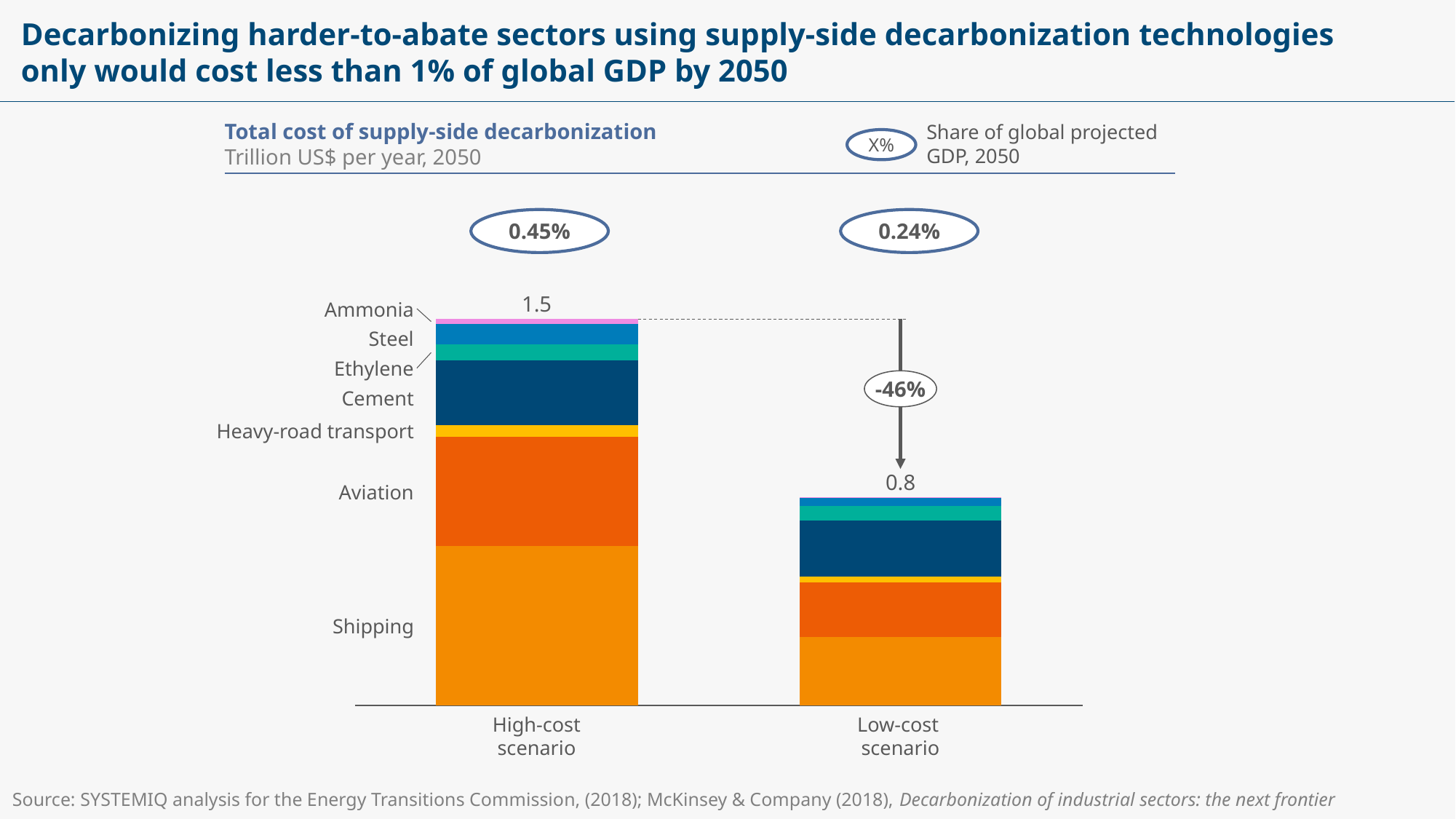
What type of chart is shown on the slide? Stacked bar chart What is the total cost of supply-side decarbonization in the High-cost scenario? 1.5 How many sectors are stacked in each bar? 7 How many scenarios (bars) are shown in the chart? 2 Which sector forms the largest segment of the High-cost scenario bar? Shipping What share of global projected GDP in 2050 does the Low-cost scenario represent? 0.24% Which scenario has the higher total cost? High-cost scenario What is the total cost of supply-side decarbonization in the Low-cost scenario? 0.8 What is the difference in total cost between the High-cost and Low-cost scenarios, in trillion US$ per year? 0.7 What percentage change is shown between the High-cost and Low-cost scenario totals? -46% Which scenario has the lower total cost? Low-cost scenario What share of global projected GDP in 2050 does the High-cost scenario represent? 0.45%